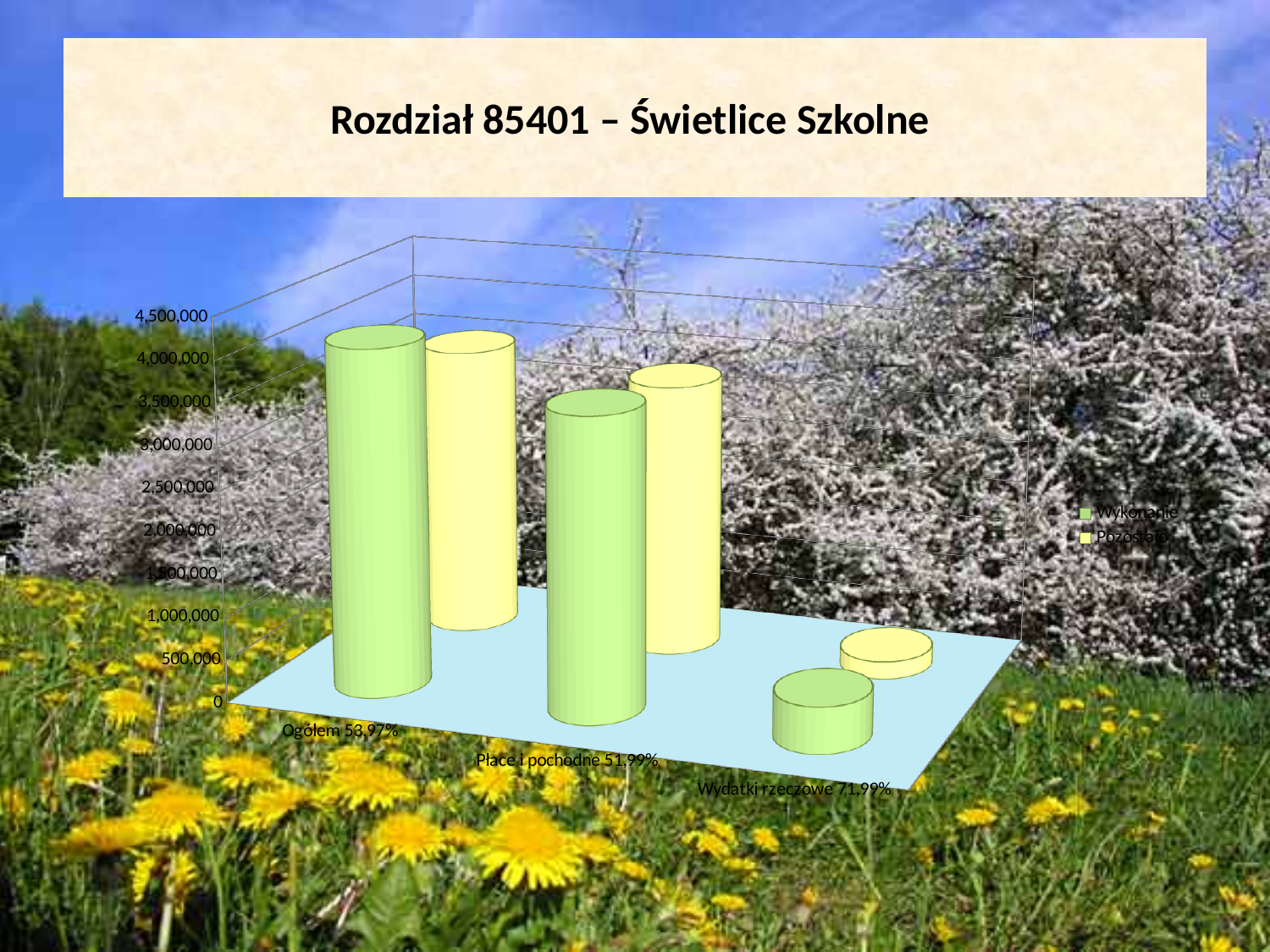
Which category has the lowest Wykonanie value? Wydatki rzeczowe What is the title of the chart on the slide? Rozdział 85401 – Świetlice Szkolne Which category has the highest Wykonanie value? Ogółem Is the Wykonanie value for Ogółem greater or less than 2,000,000? greater Which series is shown in green in the legend? Wykonanie What percentage is printed in the category label for Wydatki rzeczowe? 71,99% How many categories are shown on the x axis? 3 How many series does the legend list? 2 What kind of chart is shown on the slide? bar chart Is the Pozostało value for Płace i pochodne greater or less than 2,000,000? greater Is the Wykonanie value for Wydatki rzeczowe greater or less than 1,000,000? less Which is larger: the Wykonanie value for Ogółem or the Wykonanie value for Wydatki rzeczowe? Ogółem